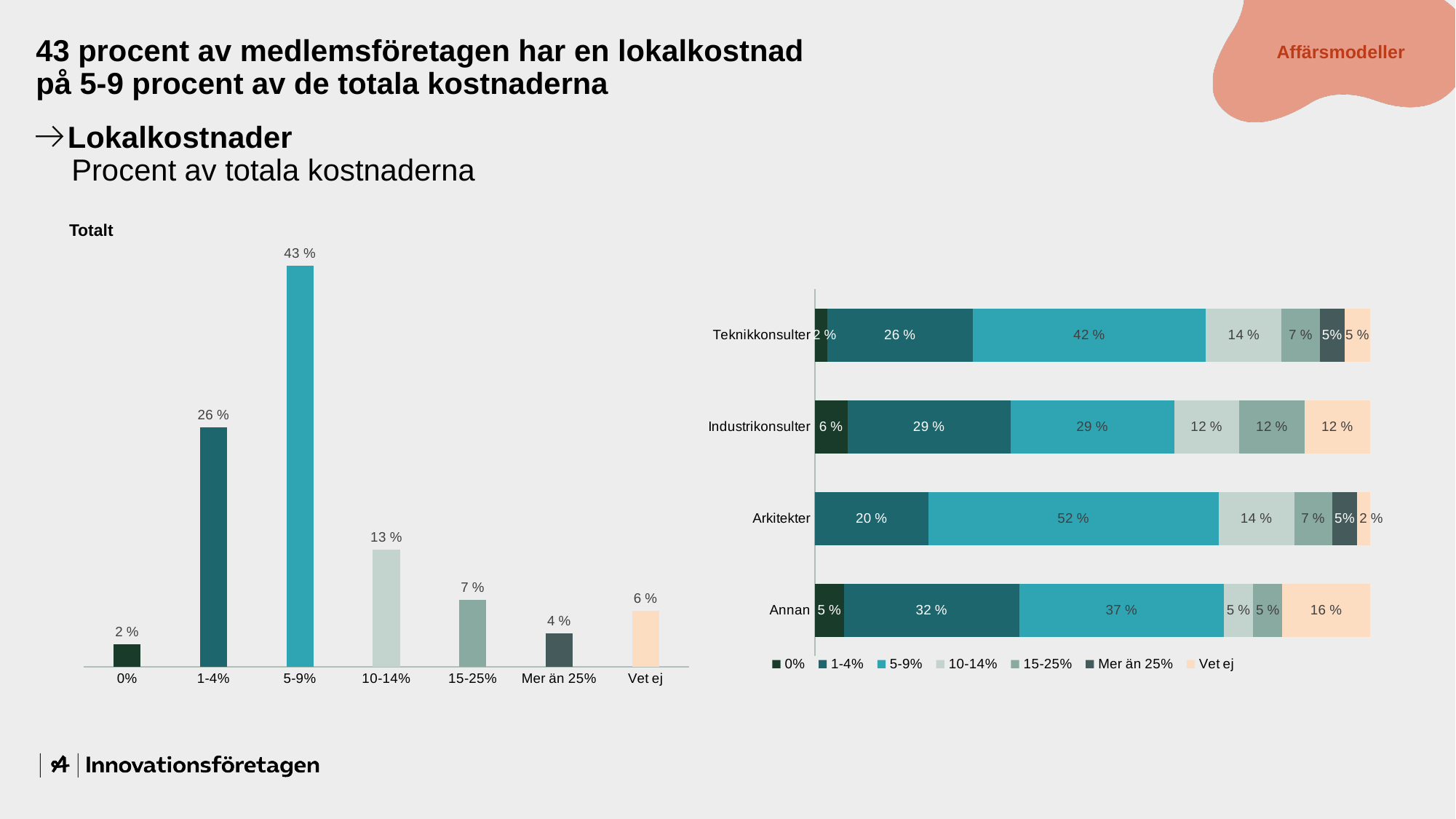
In the stacked bar chart on the right, what is the 5-9% value for Arkitekter? 52 % In the 'Totalt' chart on the left, which category has the lowest value? 0% In the stacked bar chart on the right, how many series does the legend list? 7 In the 'Totalt' chart on the left, what is the difference between the 1-4% and 10-14% categories? 13 % In the stacked bar chart on the right, which group has the highest 5-9% value? Arkitekter In the 'Totalt' chart on the left, what is the value for the 5-9% category? 43 % In the stacked bar chart on the right, how many groups are shown on the vertical axis? 4 In the stacked bar chart on the right, what is the Vet ej value for Annan? 16 % In the stacked bar chart on the right, what is the difference between the 1-4% values for Annan and Teknikkonsulter? 6 % What kind of chart is the 'Totalt' chart on the left? Bar chart In the 'Totalt' chart on the left, how many categories are shown on the x axis? 7 In the 'Totalt' chart on the left, which is larger: the value for 15-25% or the value for Vet ej? 15-25%